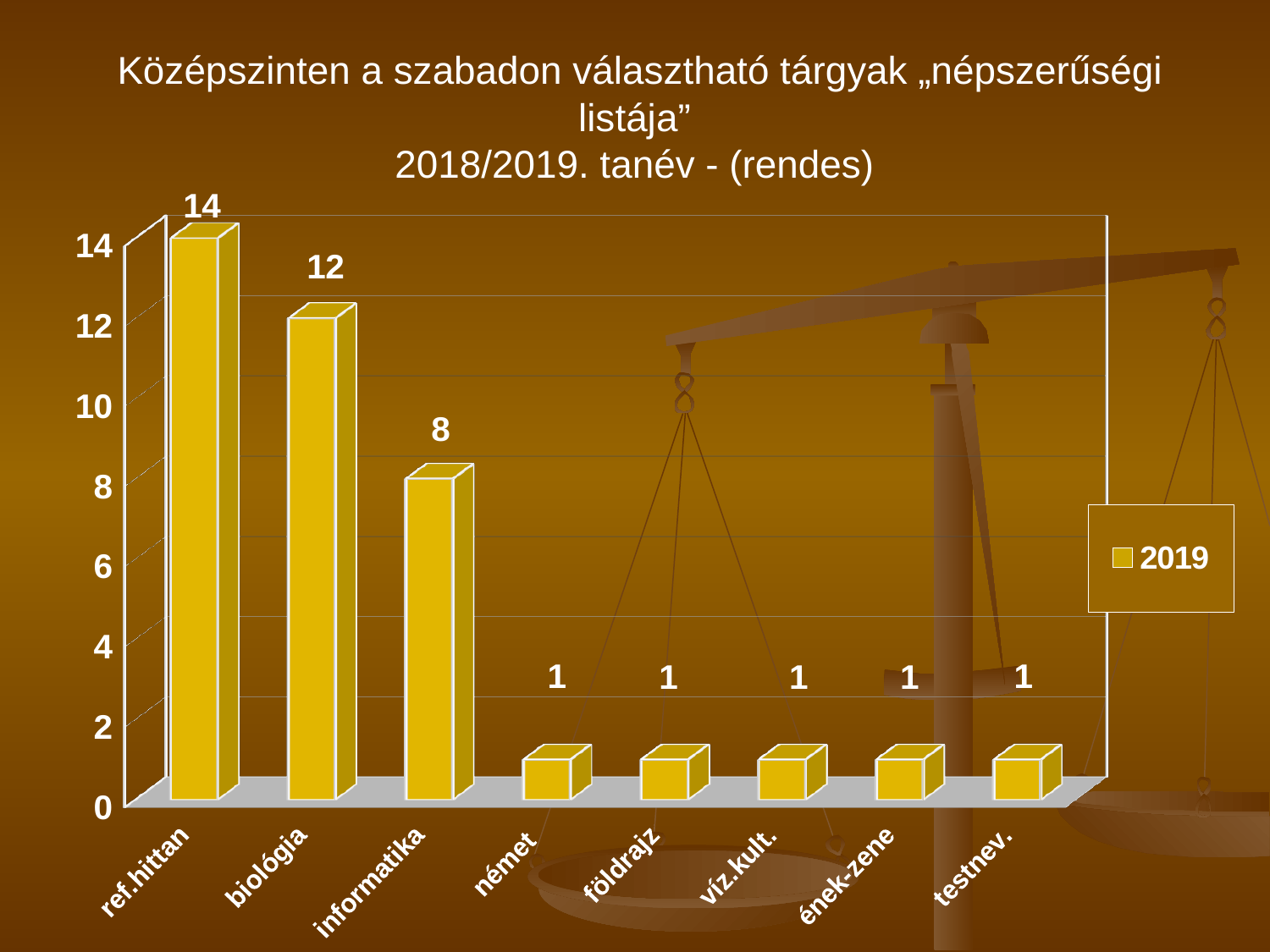
What kind of chart is shown on the slide? bar chart What is the value for ref.hittan? 14 How many series does the legend list? 1 What is the value for földrajz? 1 What series name is shown in the legend? 2019 Which category has the highest value? ref.hittan What is the value for informatika? 8 How many categories are shown on the x axis? 8 What is the difference between the values for ref.hittan and biológia? 2 Which is larger, the value for informatika or the value for német? informatika What is the value for biológia? 12 What is the difference between the values for biológia and informatika? 4